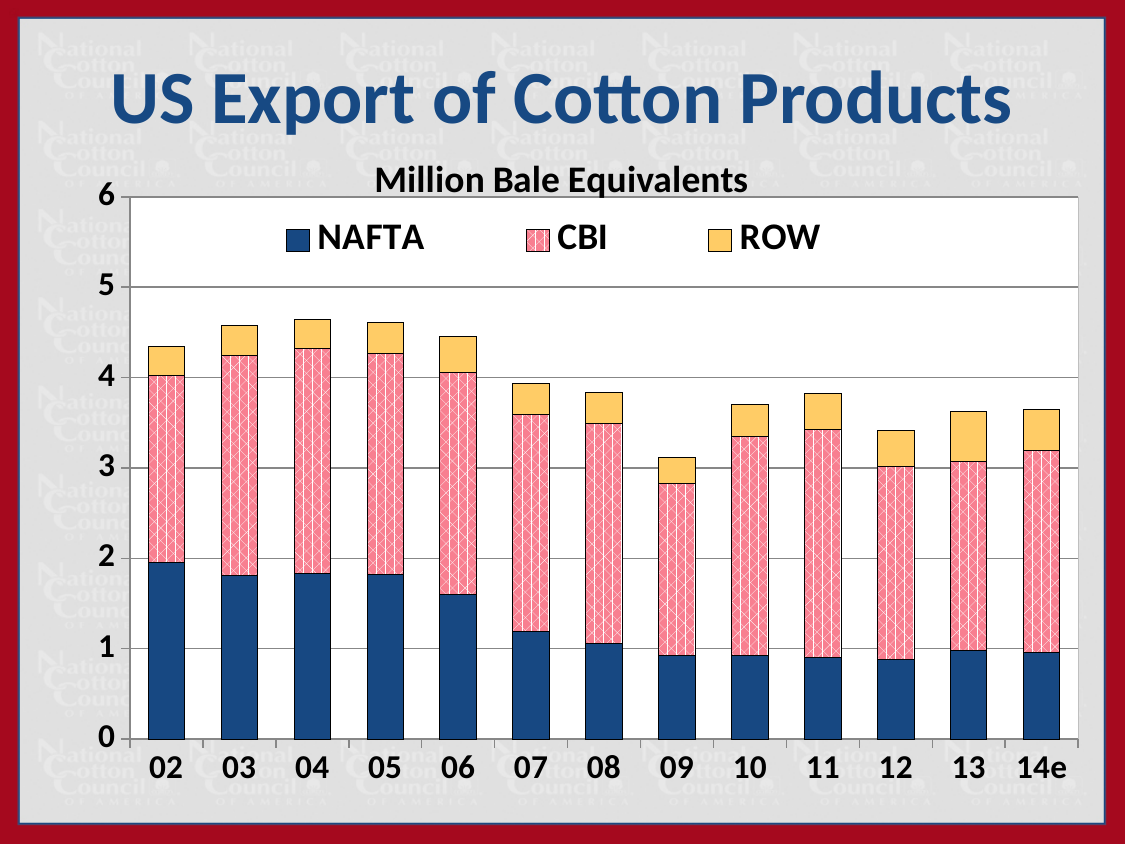
Which year has the highest NAFTA value? 02 Is the NAFTA value for 09 greater or less than 1? less Is the NAFTA value for 07 greater or less than 1? greater How many years are shown on the x axis? 13 What kind of chart is shown on the slide? Stacked bar chart Which year has the lowest total export of cotton products? 09 How many series does the legend list? 3 What unit is given above the chart? Million Bale Equivalents Which year has the larger total export, 02 or 09? 02 Is the total value for 09 greater or less than 4? less Does the NAFTA value rise or fall from 02 to 09? fall